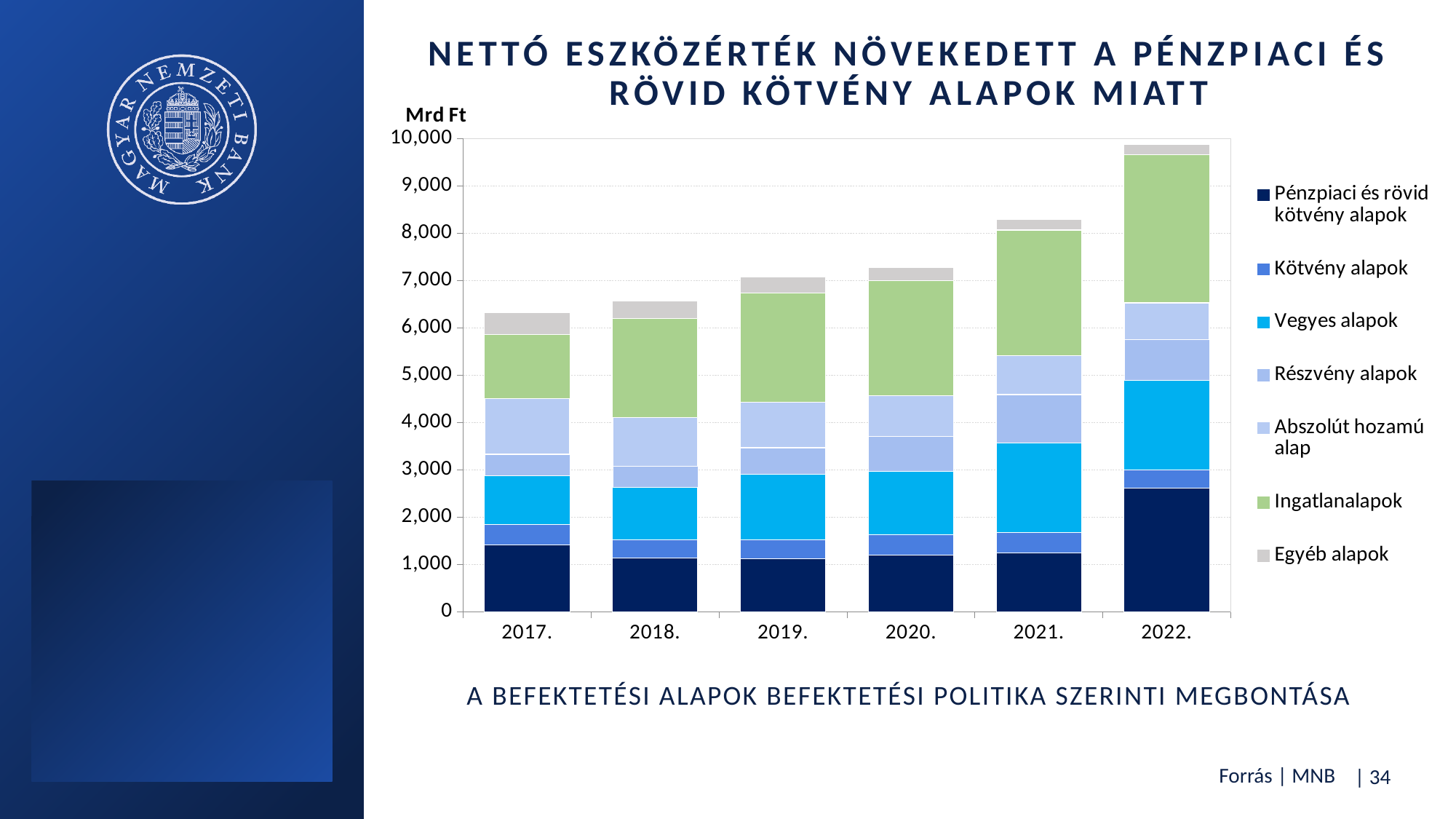
Which year has the lowest total bar? 2017. Is the Pénzpiaci és rövid kötvény alapok segment for 2022 greater or less than 2,000? greater What unit is shown above the vertical axis of the chart? Mrd Ft Do the total bar heights rise or fall from 2017 to 2022? Rise Is the total bar for 2017 greater or less than 6,000? greater How many years are shown on the x axis of the chart? 6 What kind of chart is shown on the slide? Stacked bar chart Which year has the highest total bar? 2022. Which year has the larger Pénzpiaci és rövid kötvény alapok segment, 2017 or 2022? 2022. Is the total bar for 2022 greater or less than 9,000? greater How many series does the chart's legend list? 7